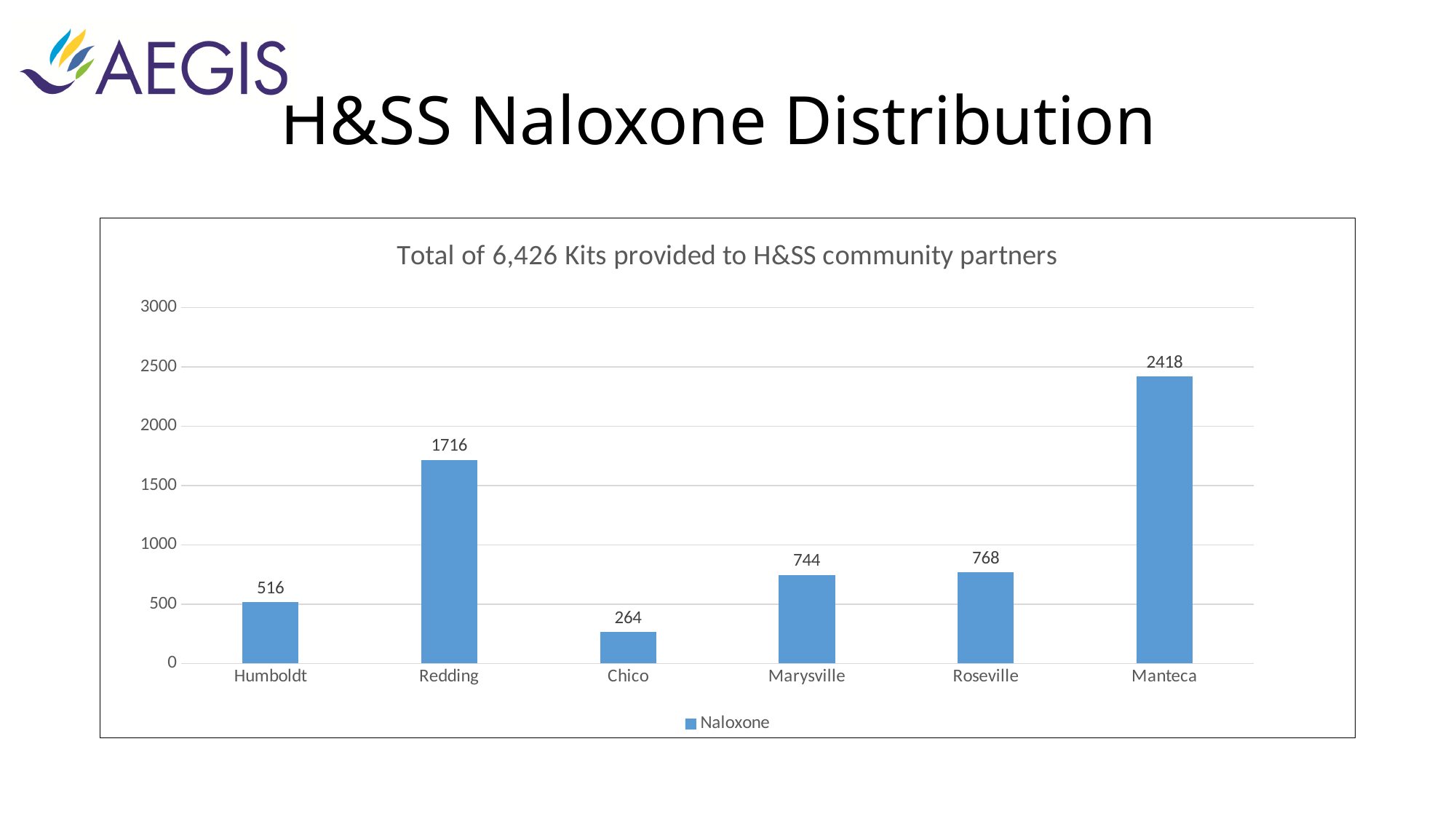
What is the Naloxone value for Redding? 1716 What is the Naloxone value for Roseville? 768 What is the difference between the Naloxone values for Roseville and Marysville? 24 Which category has the lowest Naloxone value? Chico What is the Naloxone value for Chico? 264 What is the title of the chart? Total of 6,426 Kits provided to H&SS community partners Which has a larger Naloxone value, Humboldt or Marysville? Marysville What kind of chart is shown on the slide? bar chart Is the value for Redding greater or less than 1500? greater How many categories are shown on the x axis? 6 What is the difference between the Naloxone values for Manteca and Redding? 702 Which category has the highest Naloxone value? Manteca